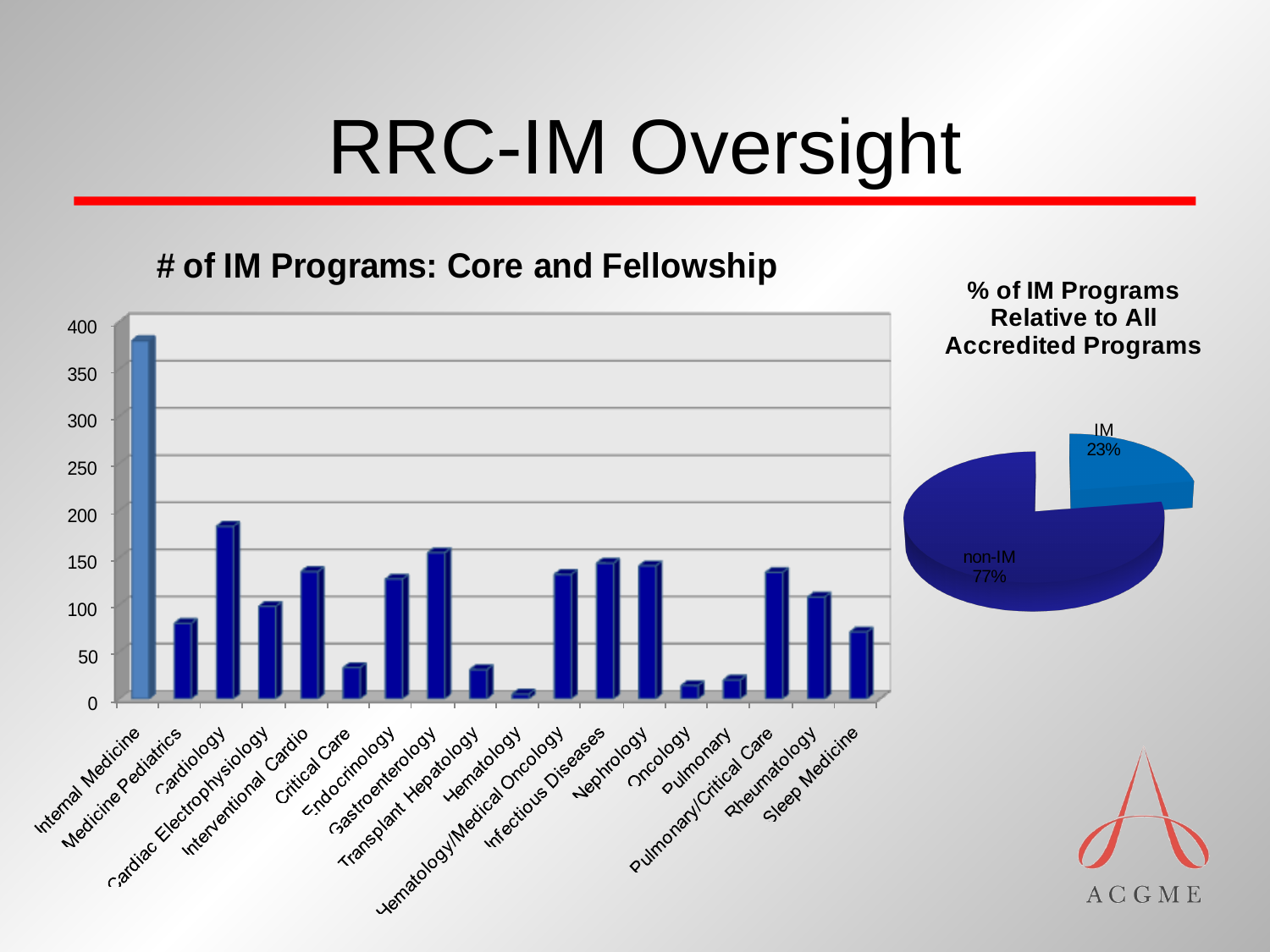
In the '# of IM Programs: Core and Fellowship' chart, which is larger, Cardiology or Medicine Pediatrics? Cardiology What type of chart is the '# of IM Programs: Core and Fellowship' chart? bar chart In the '# of IM Programs: Core and Fellowship' chart, which is larger, Gastroenterology or Transplant Hepatology? Gastroenterology In the '# of IM Programs: Core and Fellowship' chart, how many categories are shown on the x axis? 18 In the '# of IM Programs: Core and Fellowship' chart, which category has the lowest value? Hematology What type of chart is the '% of IM Programs Relative to All Accredited Programs' chart? pie chart In the '% of IM Programs Relative to All Accredited Programs' chart, what is the value for non-IM? 77% In the '# of IM Programs: Core and Fellowship' chart, is the value for Internal Medicine greater or less than 350? greater In the '# of IM Programs: Core and Fellowship' chart, is the value for Critical Care greater or less than 50? less In the '# of IM Programs: Core and Fellowship' chart, is the value for Cardiology greater or less than 150? greater In the '# of IM Programs: Core and Fellowship' chart, which category has the highest value? Internal Medicine In the '% of IM Programs Relative to All Accredited Programs' chart, what share is IM? 23%